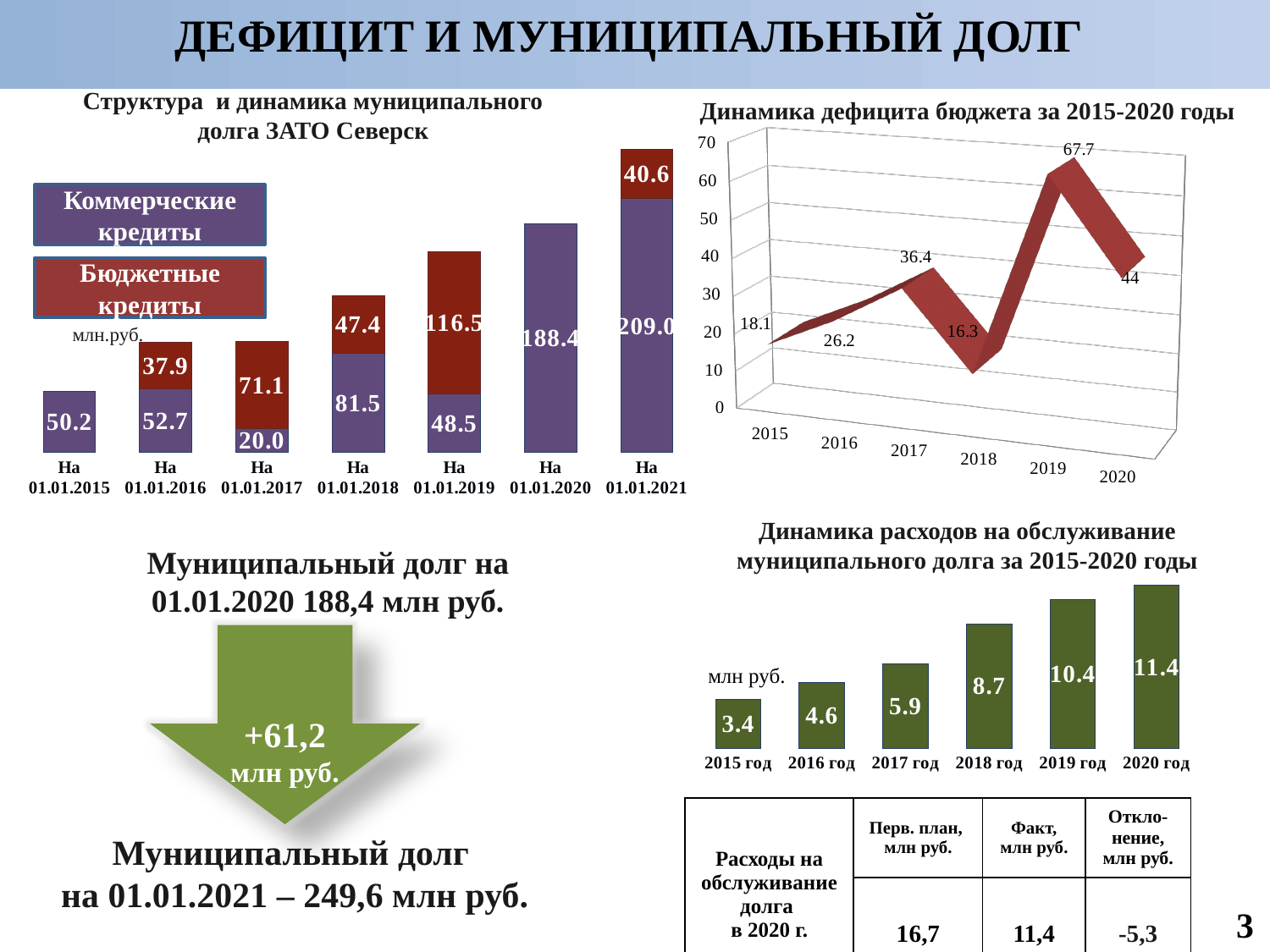
In the chart 'Динамика дефицита бюджета за 2015-2020 годы', which year has the lowest value? 2018 In the chart 'Динамика дефицита бюджета за 2015-2020 годы', what is the value for 2019? 67.7 In the chart 'Динамика расходов на обслуживание муниципального долга за 2015-2020 годы', what is the difference between the values for 2020 год and 2015 год? 8.0 In the chart 'Структура и динамика муниципального долга ЗАТО Северск', what is the total of the stacked bar for 01.01.2021? 249.6 How many series does the legend of the chart 'Структура и динамика муниципального долга ЗАТО Северск' list? 2 In the chart 'Динамика расходов на обслуживание муниципального долга за 2015-2020 годы', what is the value for 2018 год? 8.7 In the chart 'Структура и динамика муниципального долга ЗАТО Северск', what is the value of Бюджетные кредиты on 01.01.2019? 116.5 What kind of chart is 'Динамика дефицита бюджета за 2015-2020 годы'? line chart In the chart 'Динамика дефицита бюджета за 2015-2020 годы', which year has the highest value? 2019 In the chart 'Динамика расходов на обслуживание муниципального долга за 2015-2020 годы', do the values rise or fall from 2015 to 2020? rise In the chart 'Динамика дефицита бюджета за 2015-2020 годы', what is the difference between the values for 2019 and 2018? 51.4 In the chart 'Динамика дефицита бюджета за 2015-2020 годы', which is larger, the value for 2017 or the value for 2020? 2020